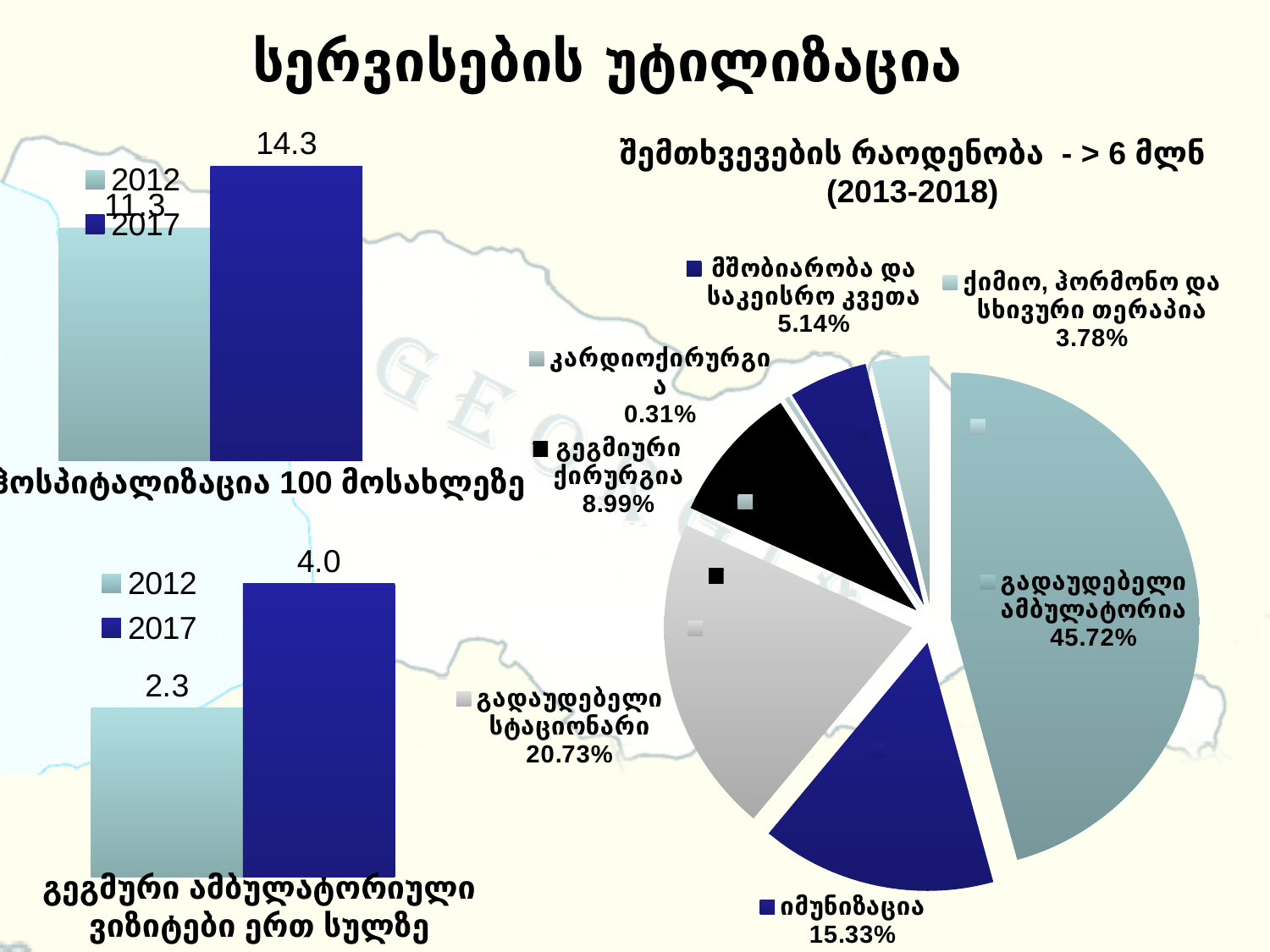
In the top-left bar chart, what is the difference between the 2017 and 2012 values? 3.0 How many series does the legend of the bottom-left bar chart list? 2 In the top-left bar chart, what is the value for 2012? 11.3 In the bottom-left bar chart, what is the value for 2012? 2.3 In the pie chart on the right, what share does გადაუდებელი ამბულატორია have? 45.72% How many slices does the pie chart on the right have? 7 In the bottom-left bar chart, what is the value for 2017? 4.0 In the top-left bar chart, what is the value for 2017? 14.3 In the bottom-left bar chart, which year has the larger value, 2012 or 2017? 2017 What kind of chart is the chart on the right of the slide? Pie chart In the pie chart on the right, which slice is the smallest? კარდიოქირურგია In the pie chart on the right, what share does იმუნიზაცია have? 15.33%